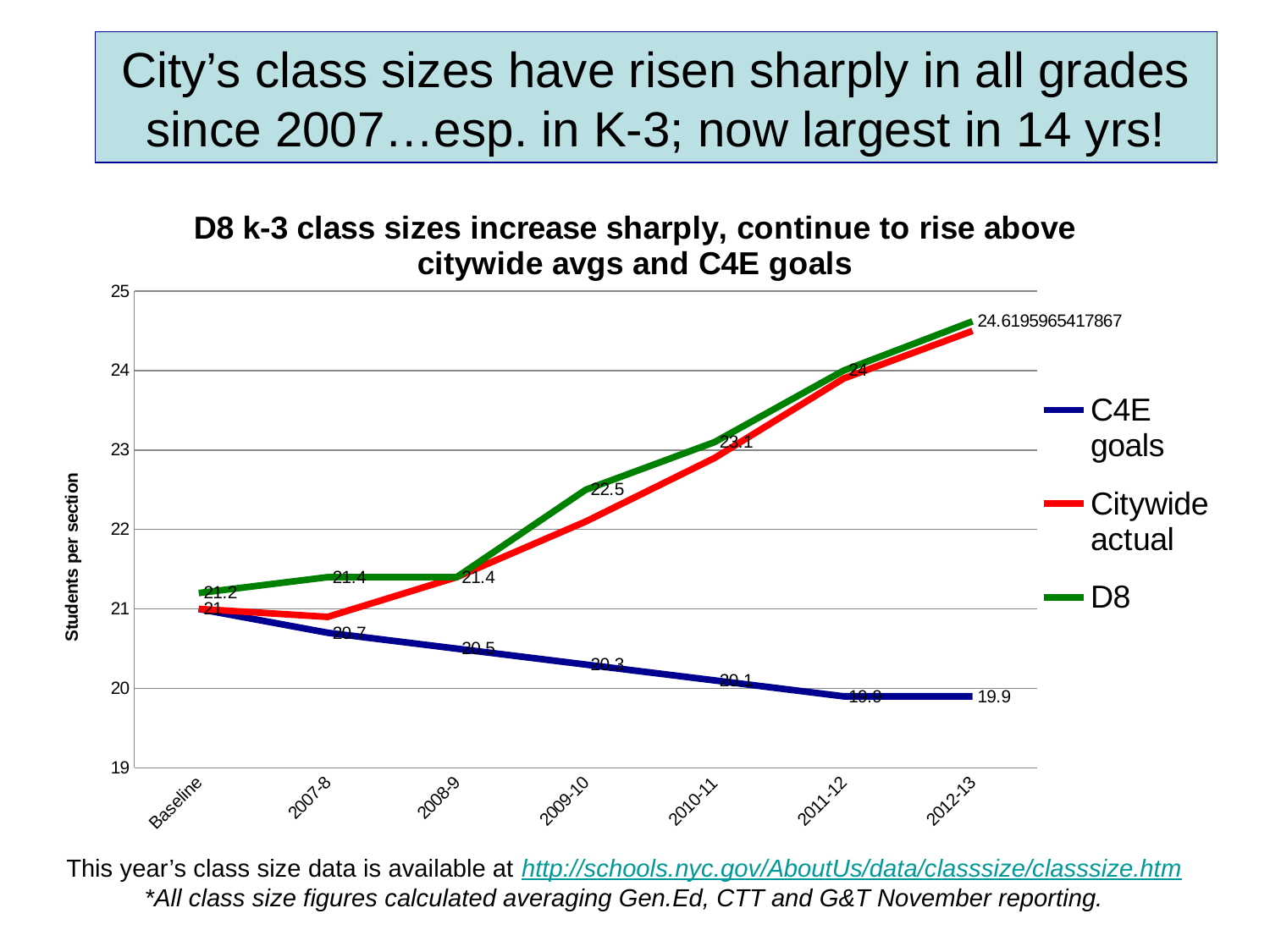
What is the D8 value for 2009-10? 22.5 In which year does the D8 series reach its highest value? 2012-13 Is the Citywide actual value for 2010-11 greater or less than 22? greater What is the C4E goals value at Baseline? 21 What is the C4E goals value for 2012-13? 19.9 How many points are plotted along the x axis for each series? 7 What kind of chart is shown on the slide? line chart How many series does the legend list? 3 Which series has the lowest value in 2012-13? C4E goals What is the difference between the D8 value for 2009-10 and the D8 value at Baseline? 1.3 Do the C4E goals values rise or fall from Baseline to 2012-13? fall What is the D8 value at Baseline? 21.2